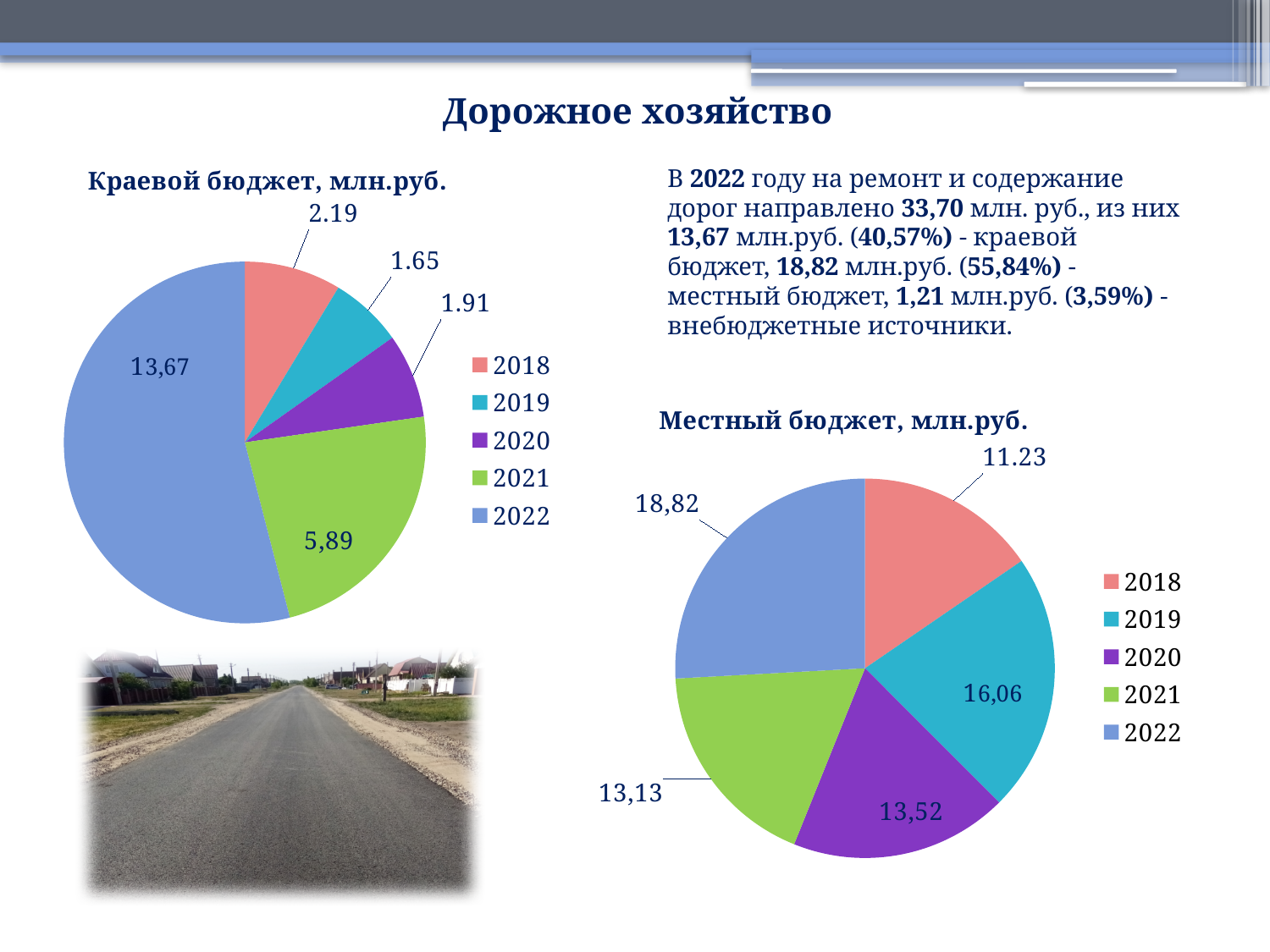
In the chart titled "Местный бюджет, млн.руб.", which year has the smallest slice? 2018 How many years does the legend of the chart titled "Местный бюджет, млн.руб." list? 5 In the chart titled "Местный бюджет, млн.руб.", what is the value for 2019? 16,06 In the chart titled "Местный бюджет, млн.руб.", which is larger, the value for 2020 or the value for 2019? 2019 In the chart titled "Местный бюджет, млн.руб.", which year has the largest slice? 2022 In the chart titled "Местный бюджет, млн.руб.", what is the value for 2018? 11.23 In the chart titled "Краевой бюджет, млн.руб.", what is the value for 2019? 1.65 What kind of chart is the chart titled "Краевой бюджет, млн.руб."? Pie chart In the chart titled "Краевой бюджет, млн.руб.", what is the difference between the values for 2022 and 2021? 7,78 In the chart titled "Краевой бюджет, млн.руб.", which year has the smallest slice? 2019 In the chart titled "Краевой бюджет, млн.руб.", which year has the largest slice? 2022 In the chart titled "Краевой бюджет, млн.руб.", what is the value for 2022? 13,67